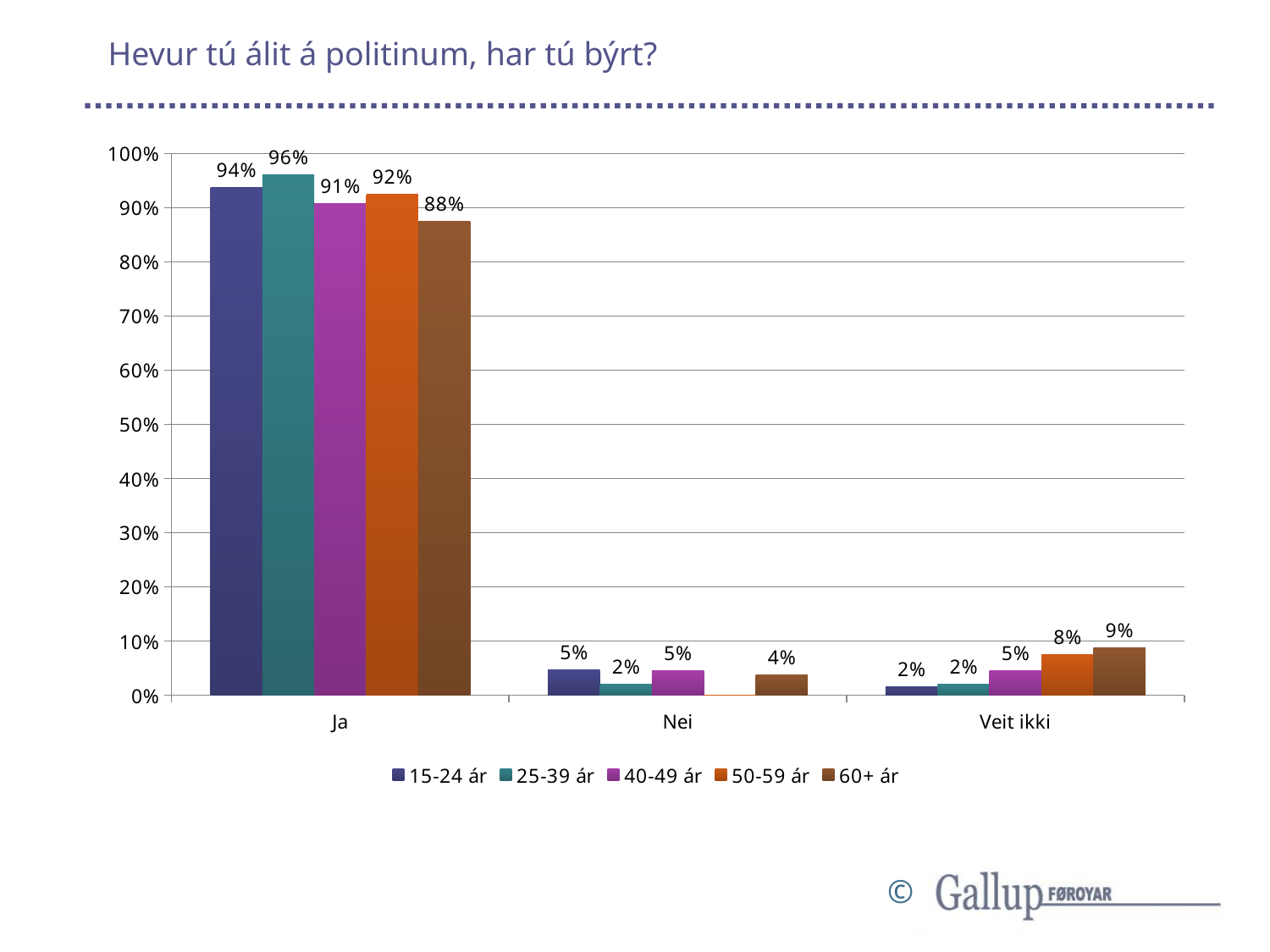
What is the difference between the 25-39 ár and 60+ ár values in the Ja category? 8% What is the value for the 40-49 ár group in the Nei category? 5% Is the value for 60+ ár in the Ja category greater or less than 80%? greater In the Veit ikki category, which is larger: the value for 50-59 ár or the value for 15-24 ár? 50-59 ár How many age groups does the legend list? 5 What is the value for the 60+ ár group in the Veit ikki category? 9% What percentage of the 25-39 ár group answered Ja? 96% What is the title of the chart? Hevur tú álit á politinum, har tú býrt? What kind of chart is shown on the slide? bar chart How many answer categories are shown on the x axis? 3 Which age group has the lowest value in the Ja category? 60+ ár Which age group has the highest value in the Ja category? 25-39 ár